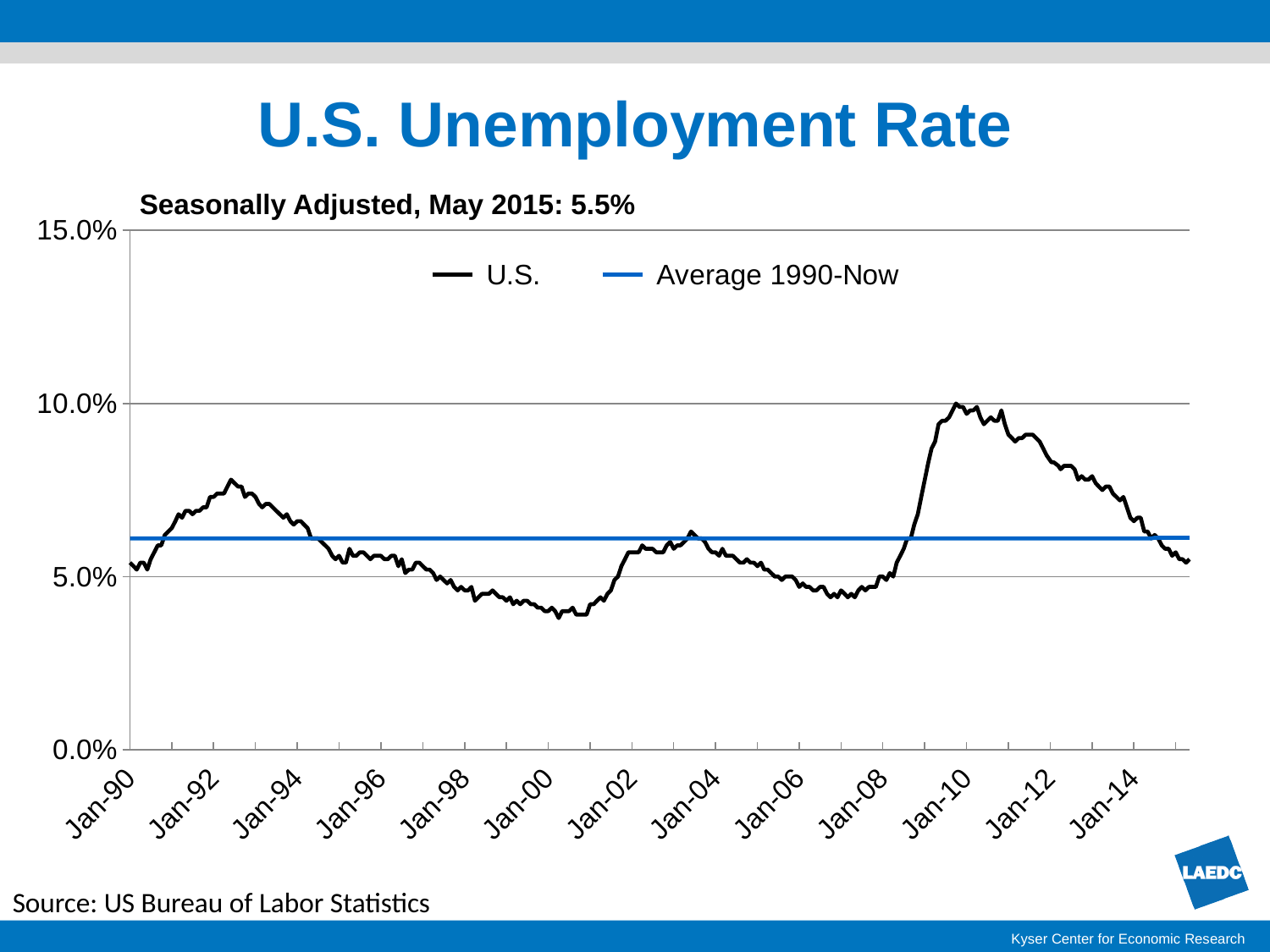
According to the subtitle, what was the seasonally adjusted U.S. unemployment rate in May 2015? 5.5% Among the labeled x-axis dates, at which one is the U.S. unemployment rate highest? Jan-10 Does the U.S. unemployment rate rise or fall between Jan-10 and Jan-14? fall How many series does the legend list? 2 Is the U.S. unemployment rate at Jan-00 greater or less than 5.0%? less Is the Average 1990-Now line greater or less than 5.0%? greater How many date labels are shown on the x axis? 13 What is the title of the chart? U.S. Unemployment Rate Which is larger, the U.S. unemployment rate at Jan-10 or at Jan-00? Jan-10 What are the two series named in the legend? U.S. and Average 1990-Now Is the U.S. unemployment rate at Jan-12 greater or less than 5.0%? greater What kind of chart is shown on the slide? line chart